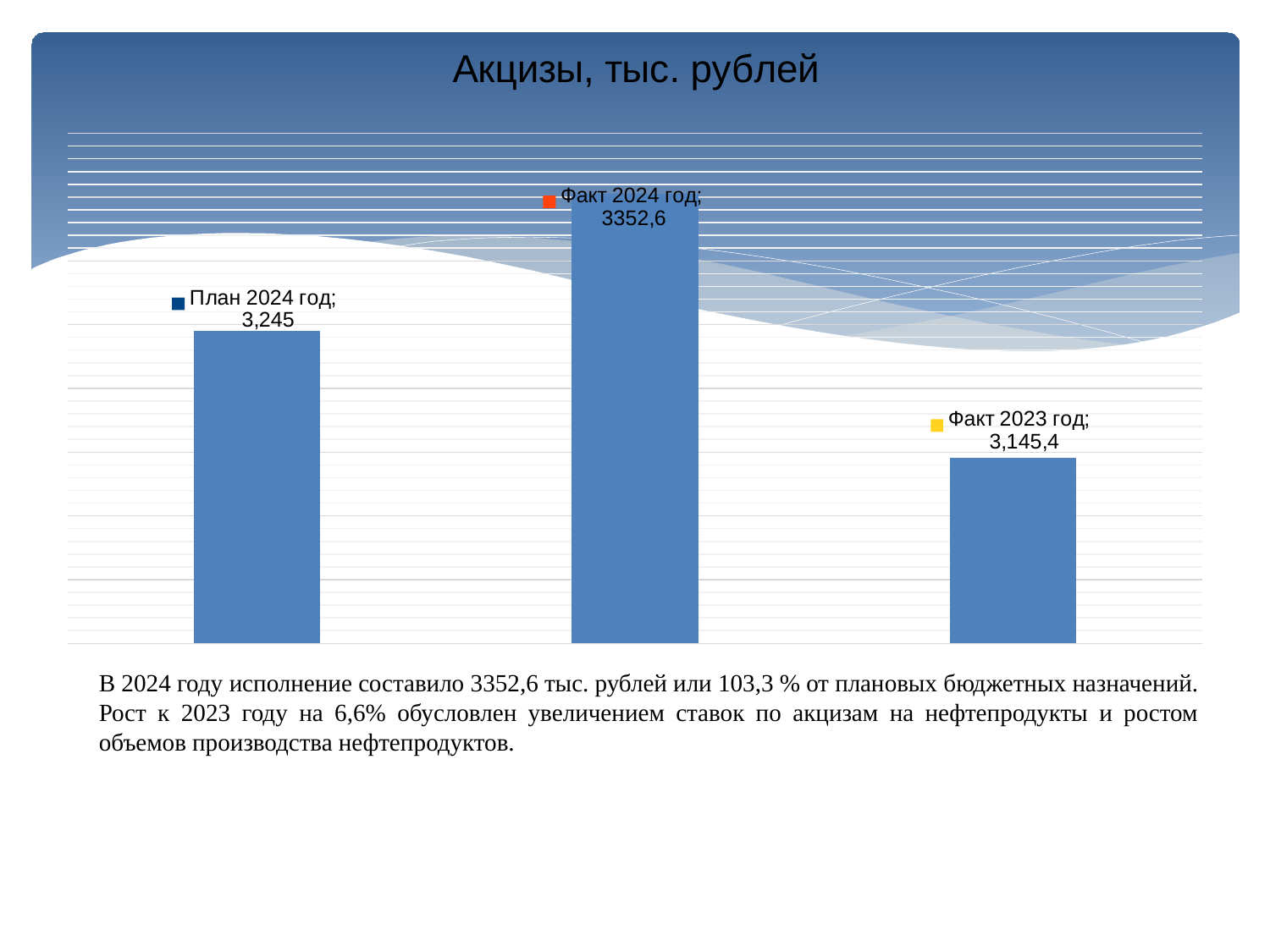
What is the title of the chart? Акцизы, тыс. рублей What is the value shown for Факт 2023 год? 3,145,4 How many bars are plotted in the chart? 3 Which category has the lowest bar? Факт 2023 год Which category has the highest bar? Факт 2024 год Which is larger, the value for План 2024 год or the value for Факт 2023 год? План 2024 год By how much does the value for Факт 2024 год exceed the value for План 2024 год? 107,6 What is the value shown for Факт 2024 год? 3352,6 What kind of chart is shown on the slide? Bar chart What is the value shown for План 2024 год? 3,245 Which is larger, the value for План 2024 год or the value for Факт 2024 год? Факт 2024 год